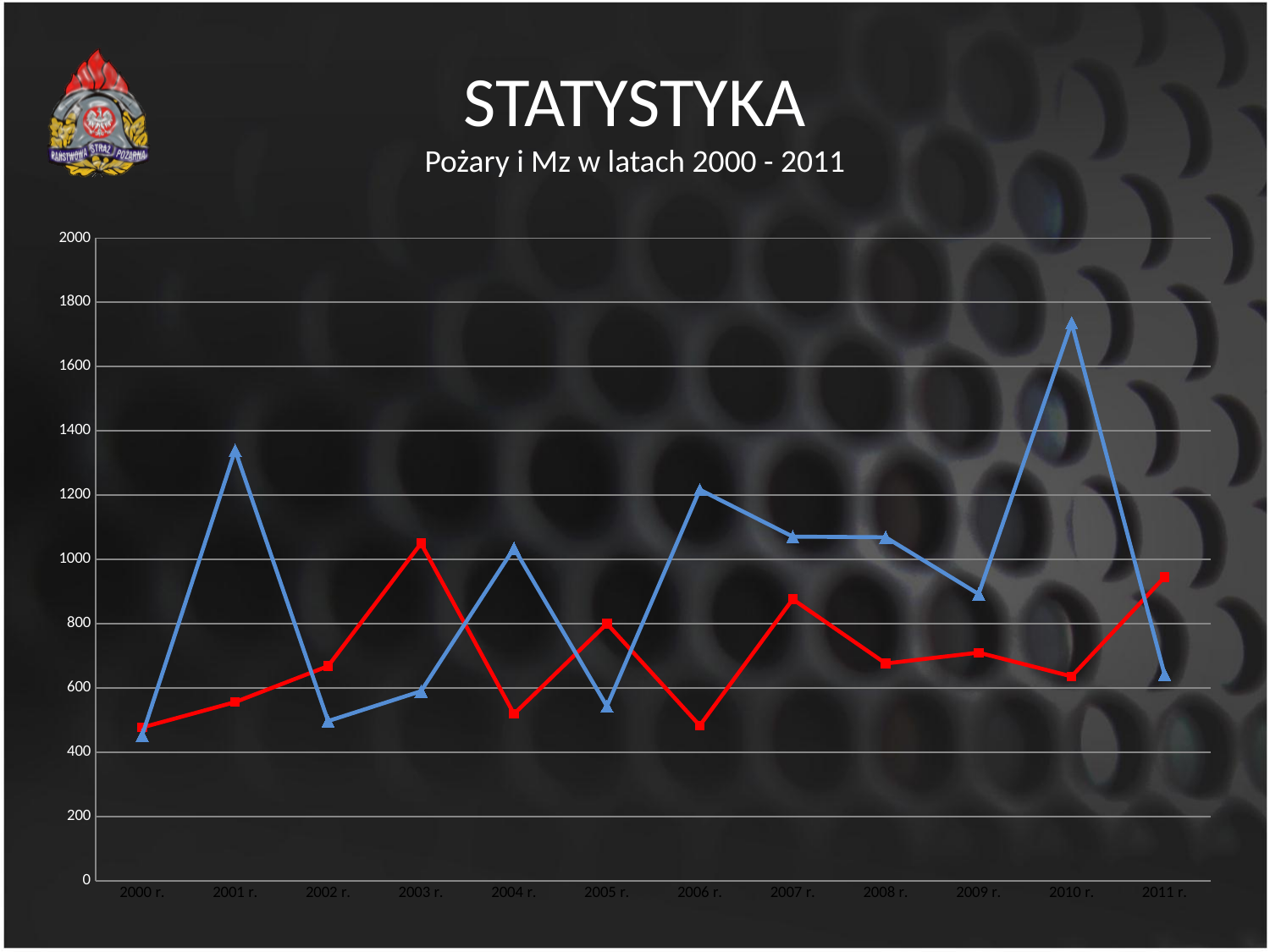
In which year does the red line reach its highest value? 2003 r. For 2003 r., which line has the higher value, the blue line or the red line? the red line Is the value of the blue line for 2001 r. greater or less than 1200? greater What kind of chart is shown on the slide? line chart Is the value of the blue line for 2005 r. greater or less than 600? less Is the value of the red line for 2003 r. greater or less than 1000? greater For 2010 r., which line has the higher value, the blue line or the red line? the blue line How many years are plotted along the x axis of the chart? 12 In which year does the blue line reach its highest value? 2010 r. How many lines are plotted on the chart? 2